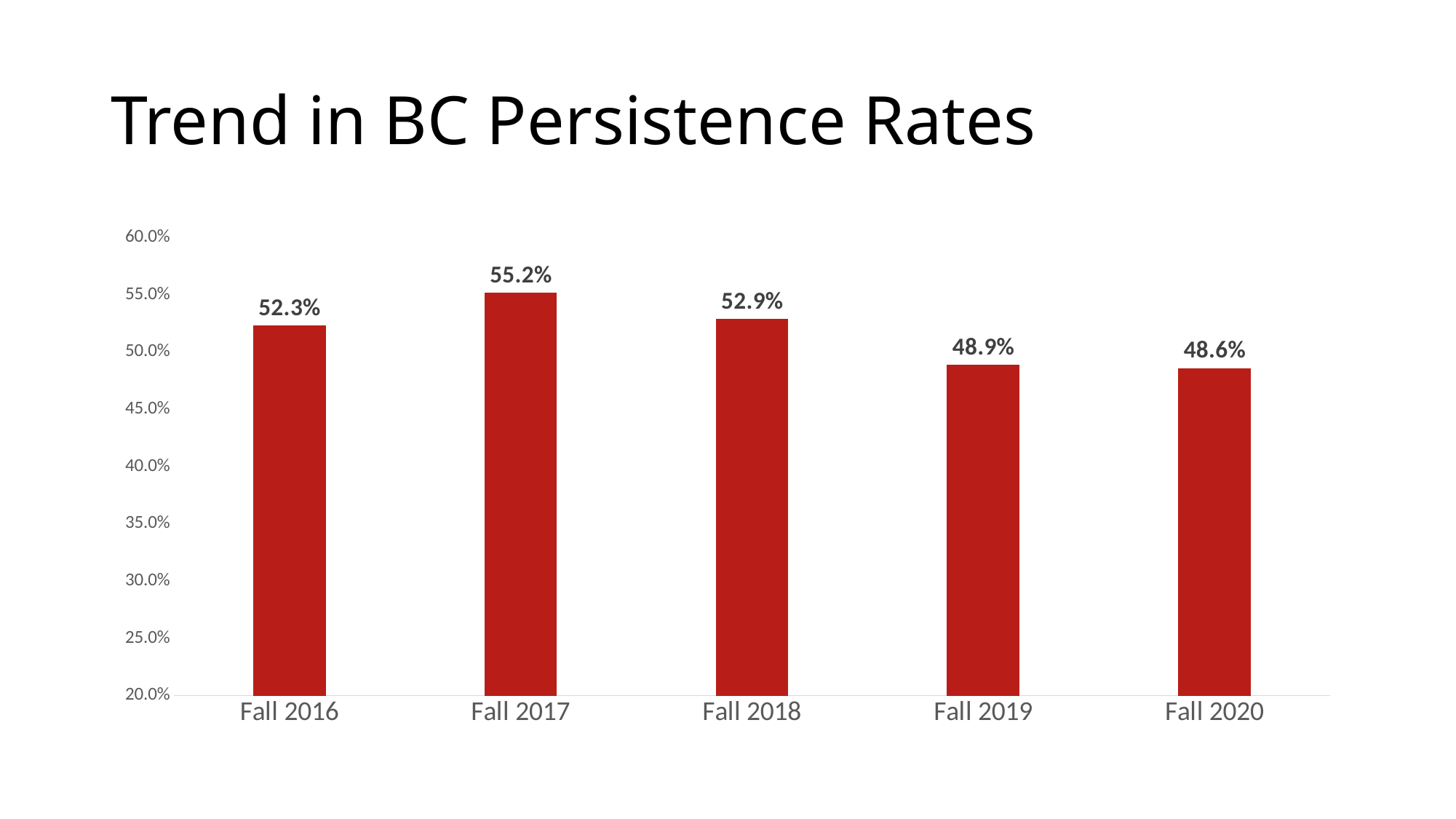
Which term has the lowest persistence rate? Fall 2020 Which is larger, the persistence rate for Fall 2018 or for Fall 2019? Fall 2018 What is the difference between the Fall 2018 and Fall 2016 persistence rates? 0.6% What is the persistence rate for Fall 2017? 55.2% Is the value for Fall 2019 greater or less than 50.0%? less How many terms are shown on the x axis? 5 Which term has the highest persistence rate? Fall 2017 What is the persistence rate for Fall 2020? 48.6% What is the title of the slide? Trend in BC Persistence Rates What is the persistence rate for Fall 2016? 52.3% What kind of chart is shown on the slide? Bar chart What is the difference between the Fall 2017 and Fall 2019 persistence rates? 6.3%